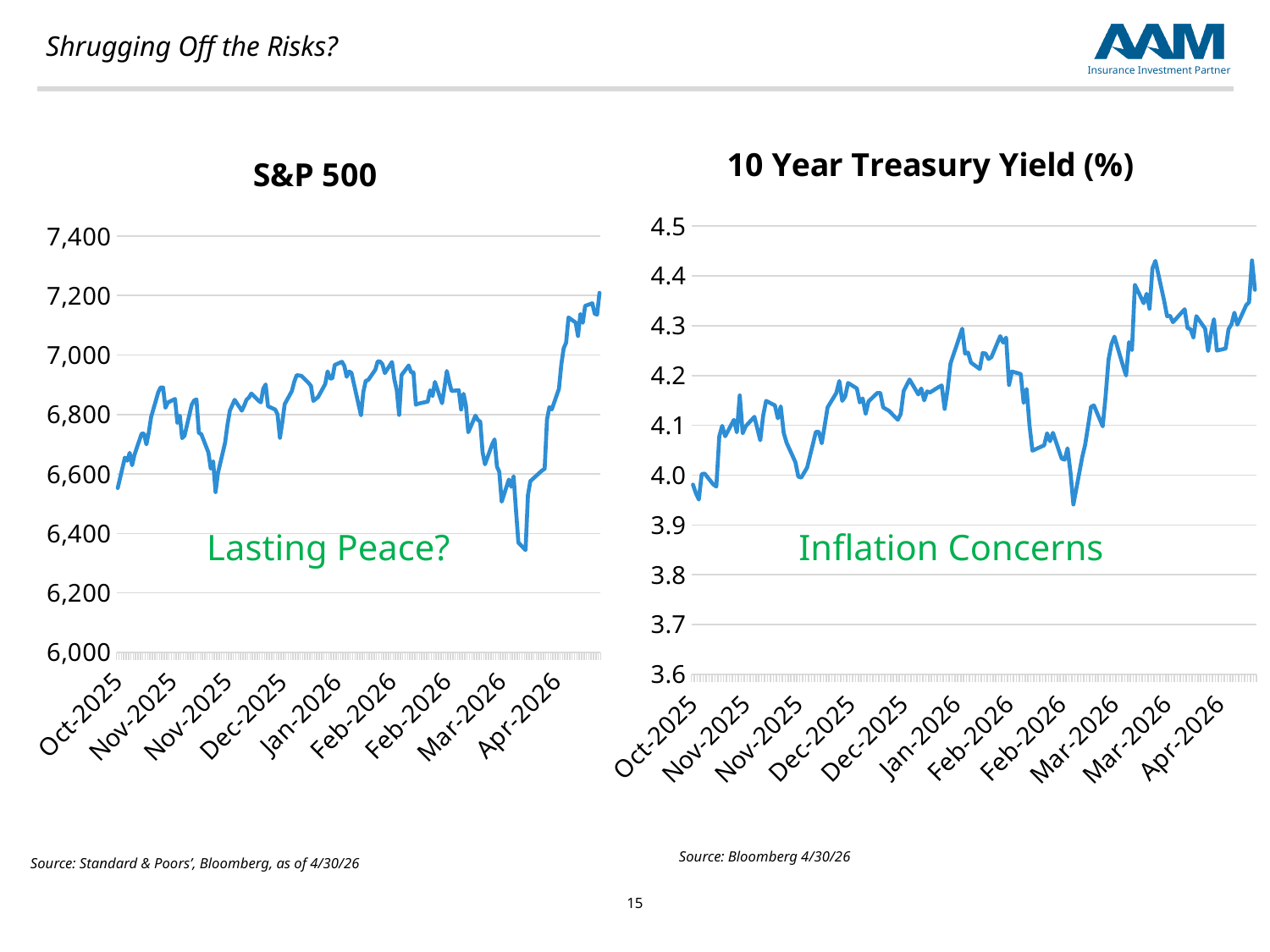
In the S&P 500 chart, does the index rise or fall overall from Oct-2025 to Apr-2026? rise What green annotation text is printed on the S&P 500 chart? Lasting Peace? In the S&P 500 chart, is the lowest point of the line, reached around Mar-2026, greater or less than 6,600? less In the S&P 500 chart, is the value at the end of the series in Apr-2026 greater or less than 7,000? greater In the 10 Year Treasury Yield (%) chart, is the lowest point of the line, reached around Feb-2026, greater or less than 4.0? less In the 10 Year Treasury Yield (%) chart, does the yield rise or fall overall from Oct-2025 to Apr-2026? rise What green annotation text is printed on the 10 Year Treasury Yield (%) chart? Inflation Concerns What kind of chart is the S&P 500 chart on the left? Line chart What kind of chart is the 10 Year Treasury Yield (%) chart on the right? Line chart